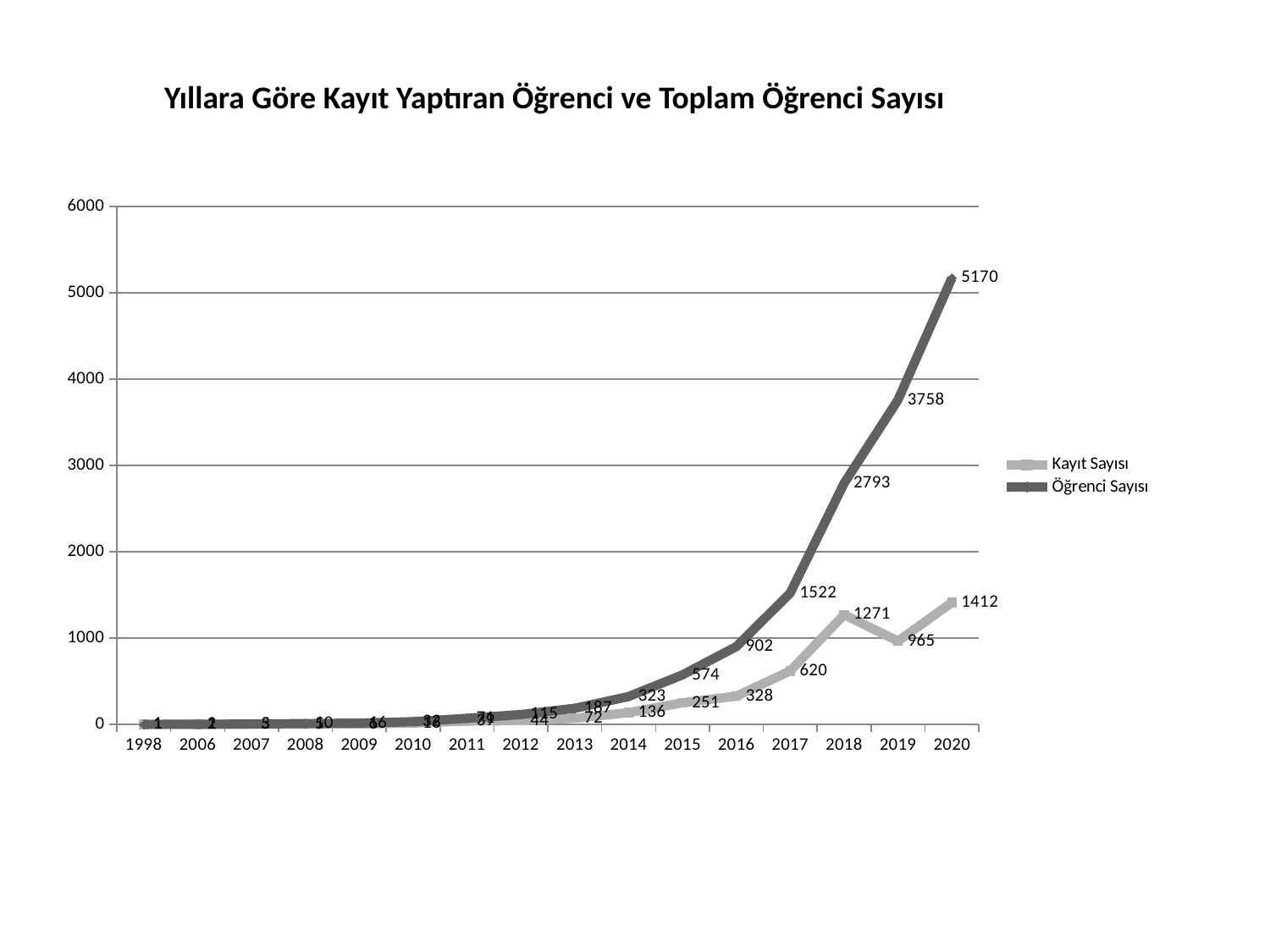
How many series does the legend list? 2 Which is larger, Kayıt Sayısı in 2018 or Kayıt Sayısı in 2019? Kayıt Sayısı in 2018 What type of chart is shown on the slide? line chart In which year is Öğrenci Sayısı highest? 2020 Is the value of Öğrenci Sayısı in 2018 greater or less than 2000? greater What is the value of Kayıt Sayısı in 2019? 965 What is the difference between Öğrenci Sayısı in 2020 and in 2019? 1412 What is the value of Öğrenci Sayısı in 2017? 1522 What is the value of Öğrenci Sayısı in 2020? 5170 How many years are shown on the x axis? 16 What is the value of Kayıt Sayısı in 2018? 1271 What is the title of the chart? Yıllara Göre Kayıt Yaptıran Öğrenci ve Toplam Öğrenci Sayısı